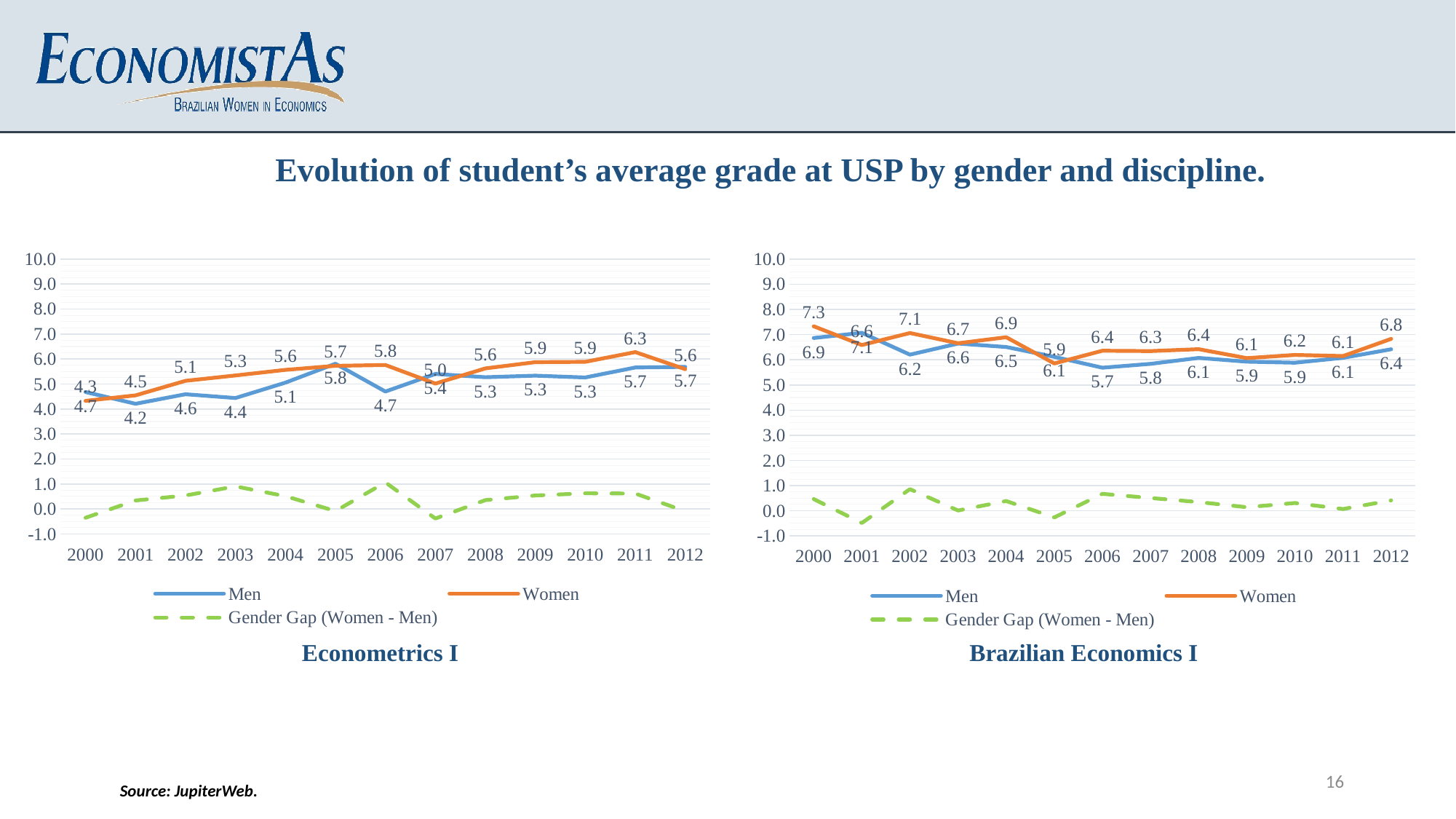
What kind of chart is the Brazilian Economics I chart? Line chart In the Econometrics I chart, which is higher in 2006, the Men or the Women average grade? Women In the Brazilian Economics I chart, what is the difference between the Women and Men average grades in 2002? 0.9 In the Econometrics I chart, which year has the lowest average grade for Men? 2001 In the Brazilian Economics I chart, is the Gender Gap (Women - Men) value in 2001 greater or less than 0.0? less In the Brazilian Economics I chart, what is the average grade for Men in 2006? 5.7 In the Brazilian Economics I chart, what is the average grade for Women in 2012? 6.8 How many series does the legend of the Econometrics I chart list? 3 In the Econometrics I chart, what is the average grade for Men in 2001? 4.2 In the Brazilian Economics I chart, which year has the lowest average grade for Men? 2006 In the Econometrics I chart, which year has the highest average grade for Women? 2011 In the Econometrics I chart, what is the average grade for Women in 2011? 6.3